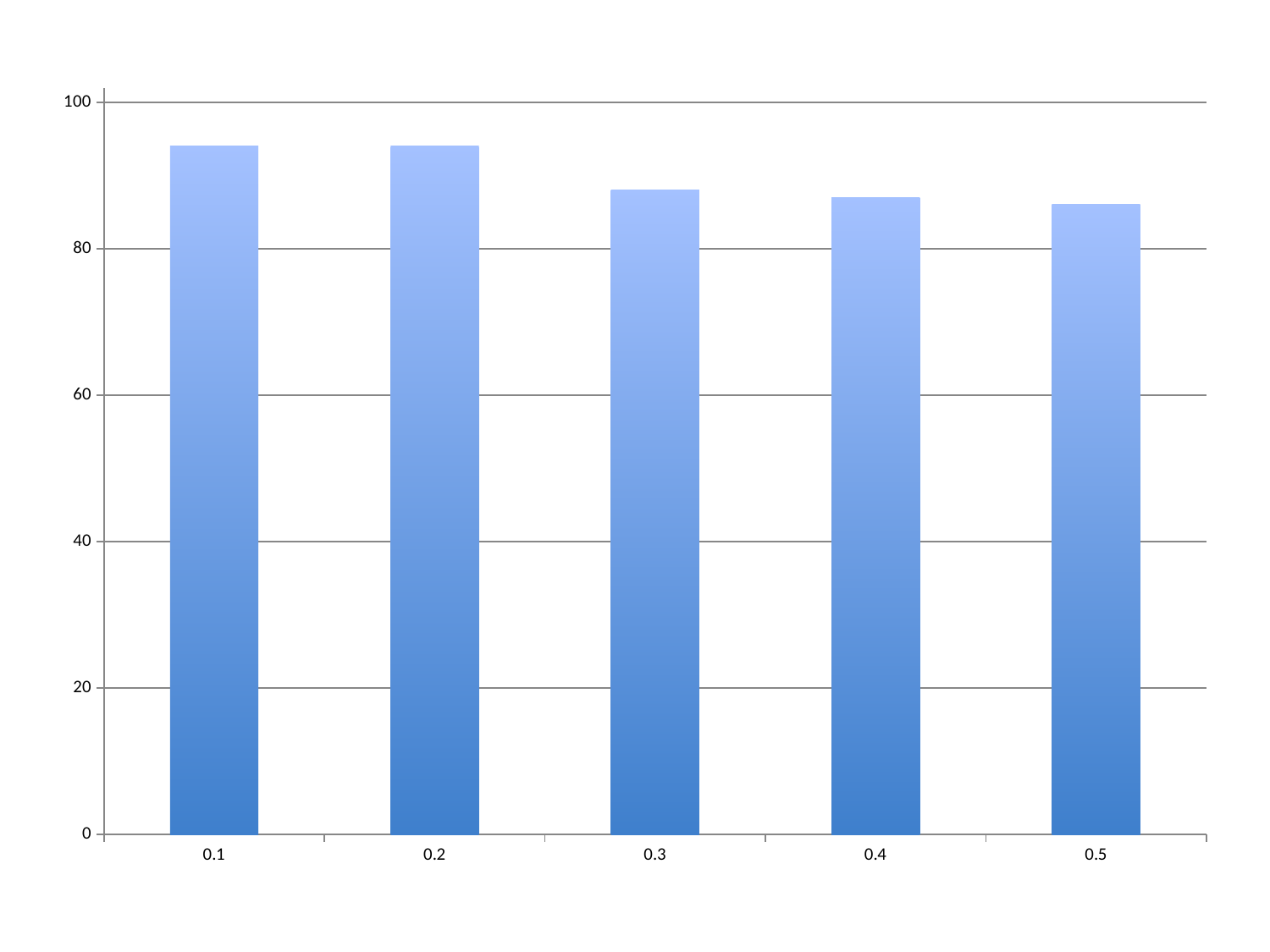
Which is larger, the value for 0.1 or the value for 0.5? 0.1 Which is larger, the value for 0.2 or the value for 0.3? 0.2 What is the label of the first category on the x-axis? 0.1 Do the values generally rise or fall as the x-axis goes from 0.1 to 0.5? fall What kind of chart is shown on the slide? bar chart How many bars are plotted in the chart? 5 Is the value for 0.5 greater or less than 80? greater Is the value for 0.3 greater or less than 100? less What is the highest tick value shown on the vertical axis? 100 Is the value for 0.1 greater or less than 80? greater